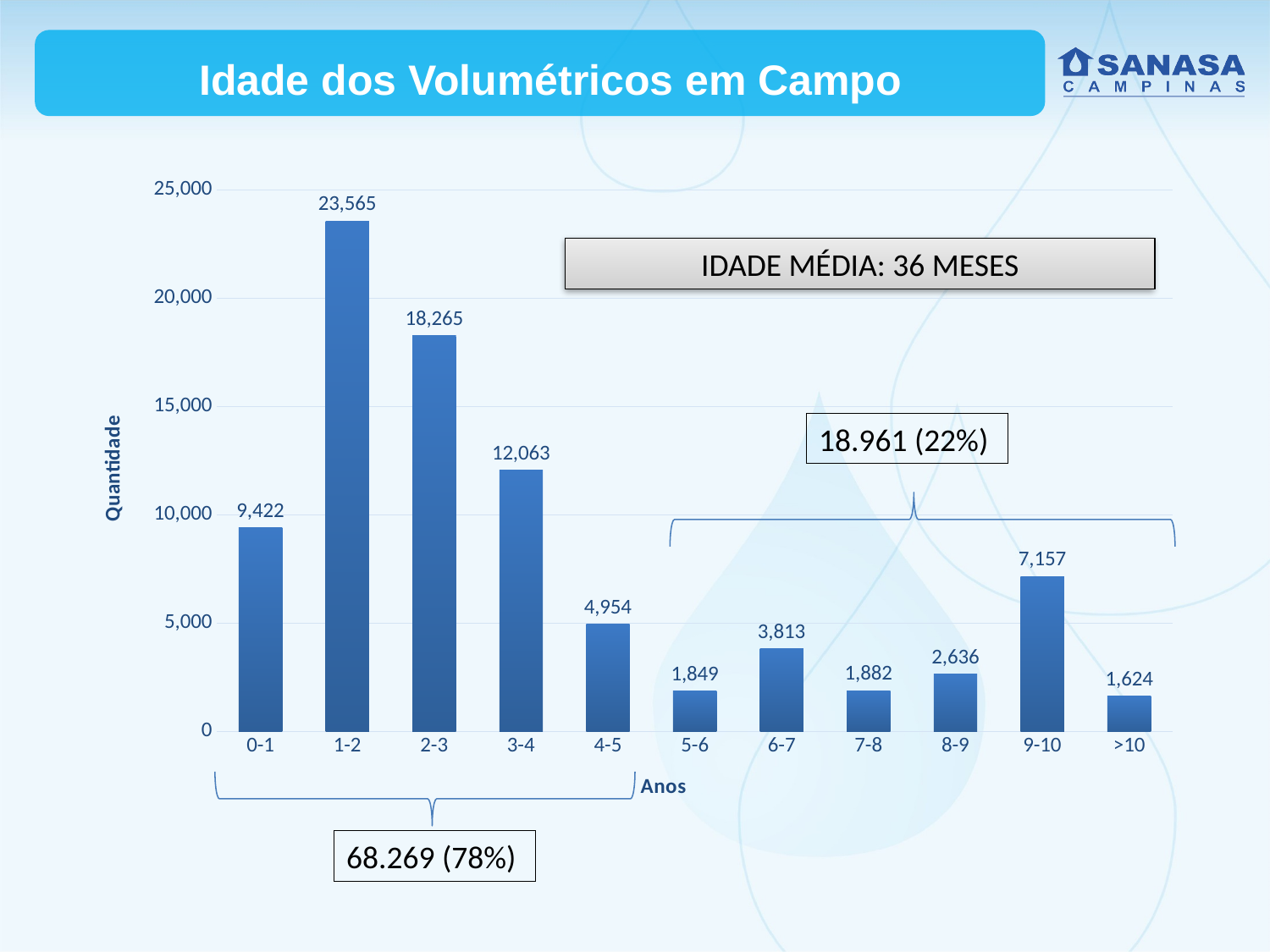
What is the label of the y axis? Quantidade Which is larger, the value for 6-7 years or the value for 8-9 years? 6-7 What kind of chart is shown on the slide? bar chart Is the value for 0-1 years greater or less than 10,000? less What is the value for the >10 years category? 1,624 What is the title of the slide? Idade dos Volumétricos em Campo What is the value for the 1-2 years category? 23,565 What is the value for the 4-5 years category? 4,954 How many age categories are shown on the x axis? 11 What is the difference between the values for 2-3 and 3-4 years? 6,202 Which age category has the lowest quantity? >10 Which age category has the highest quantity? 1-2